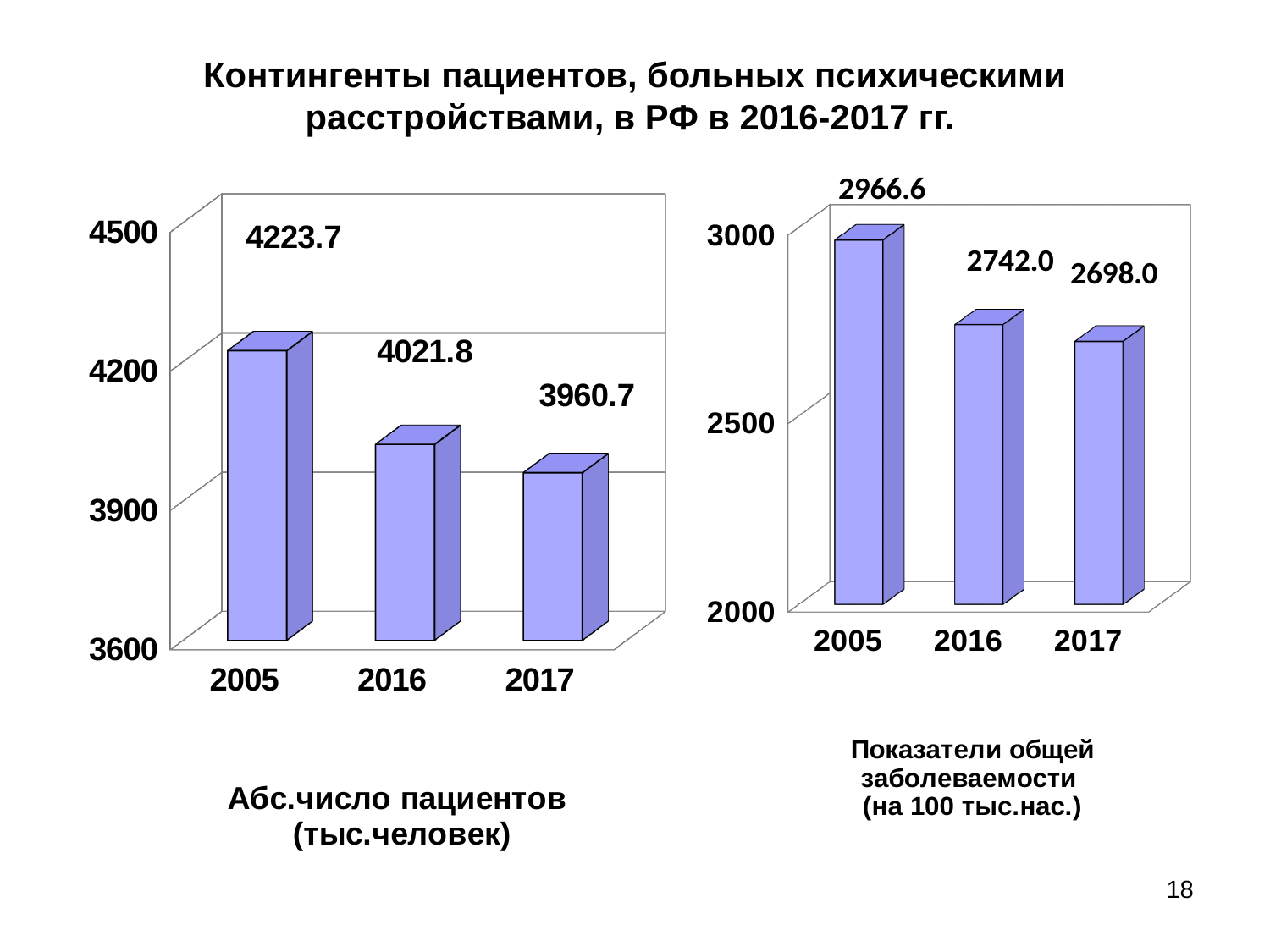
In the right chart (Показатели общей заболеваемости), which year has the highest value? 2005 What kind of chart is the left chart (Абс.число пациентов)? bar chart In the right chart (Показатели общей заболеваемости), what is the value for 2016? 2742.0 In the left chart (Абс.число пациентов), is the value for 2016 greater or less than 4200? less In the right chart (Показатели общей заболеваемости), do the values rise or fall from 2005 to 2017? fall In the left chart (Абс.число пациентов), what is the difference between the 2005 and 2017 values? 263.0 In the left chart (Абс.число пациентов), what is the value for 2017? 3960.7 In the right chart (Показатели общей заболеваемости), which is larger: the value for 2005 or the value for 2017? 2005 In the left chart (Абс.число пациентов), which year has the lowest value? 2017 How many years are shown in the right chart (Показатели общей заболеваемости)? 3 In the left chart (Абс.число пациентов), what is the value for 2005? 4223.7 In the right chart (Показатели общей заболеваемости), what is the difference between the 2016 and 2017 values? 44.0